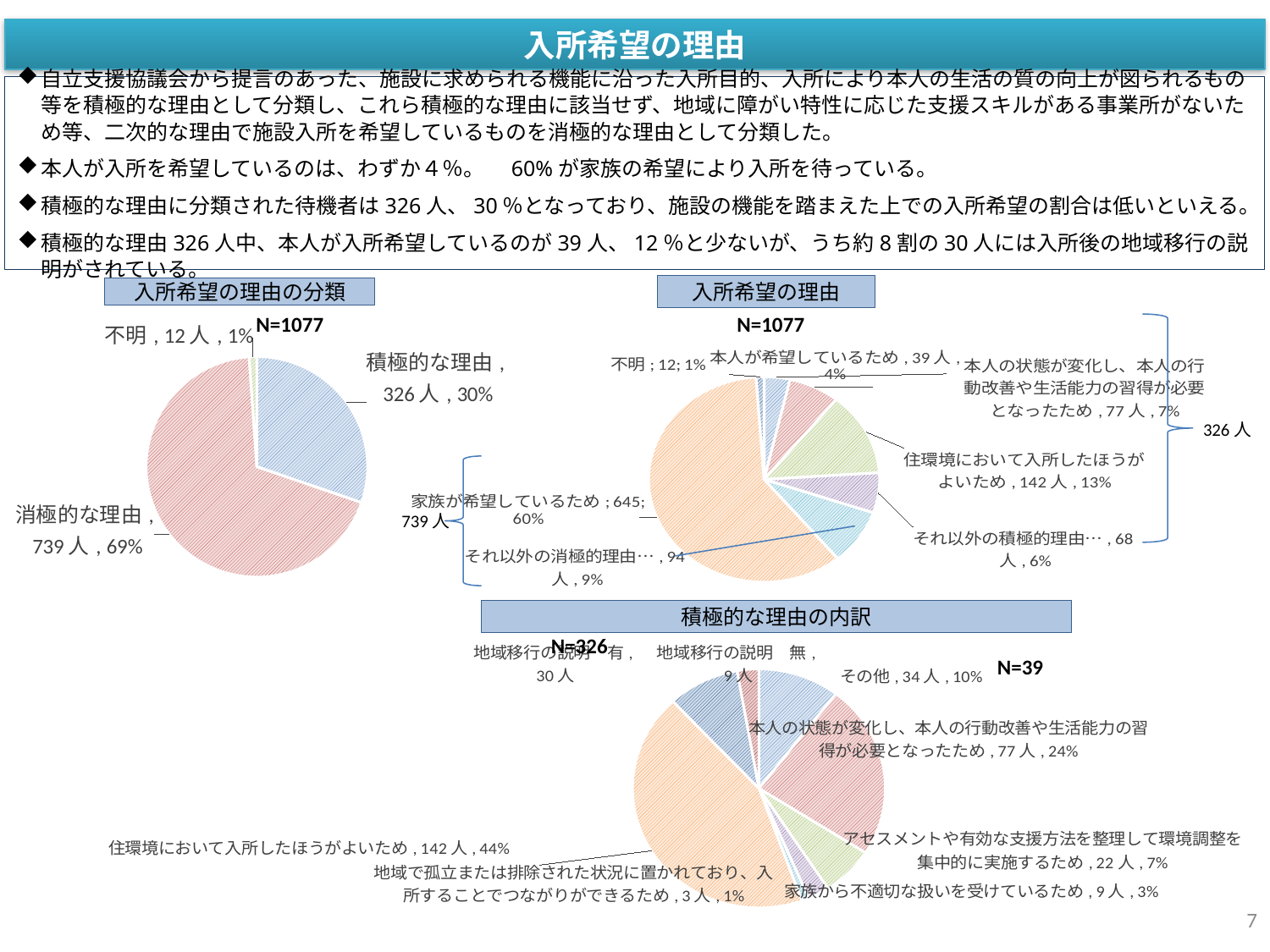
In the chart titled 入所希望の理由の分類, which category is the largest? 消極的な理由 In the chart titled 積極的な理由の内訳, what is the N value shown for the chart? N=326 In the chart titled 入所希望の理由, which category is the smallest? 不明 In the chart titled 入所希望の理由の分類, what percentage share does 消極的な理由 have? 69% What type of chart is used for 入所希望の理由の分類? pie chart In the chart titled 入所希望の理由, what percentage share does 住環境において入所したほうがよいため have? 13% In the chart titled 積極的な理由の内訳, how many people are in the 住環境において入所したほうがよいため category? 142人 In the chart titled 入所希望の理由の分類, how many people are in the 積極的な理由 category? 326人 In the chart titled 入所希望の理由の分類, what is the difference in people between 消極的な理由 and 積極的な理由? 413人 In the chart titled 積極的な理由の内訳, what percentage share does アセスメントや有効な支援方法を整理して環境調整を集中的に実施するため have? 7% In the chart titled 入所希望の理由, which has more people: 本人が希望しているため or それ以外の積極的理由? それ以外の積極的理由 In the chart titled 入所希望の理由, how many people are in the 家族が希望しているため category? 645